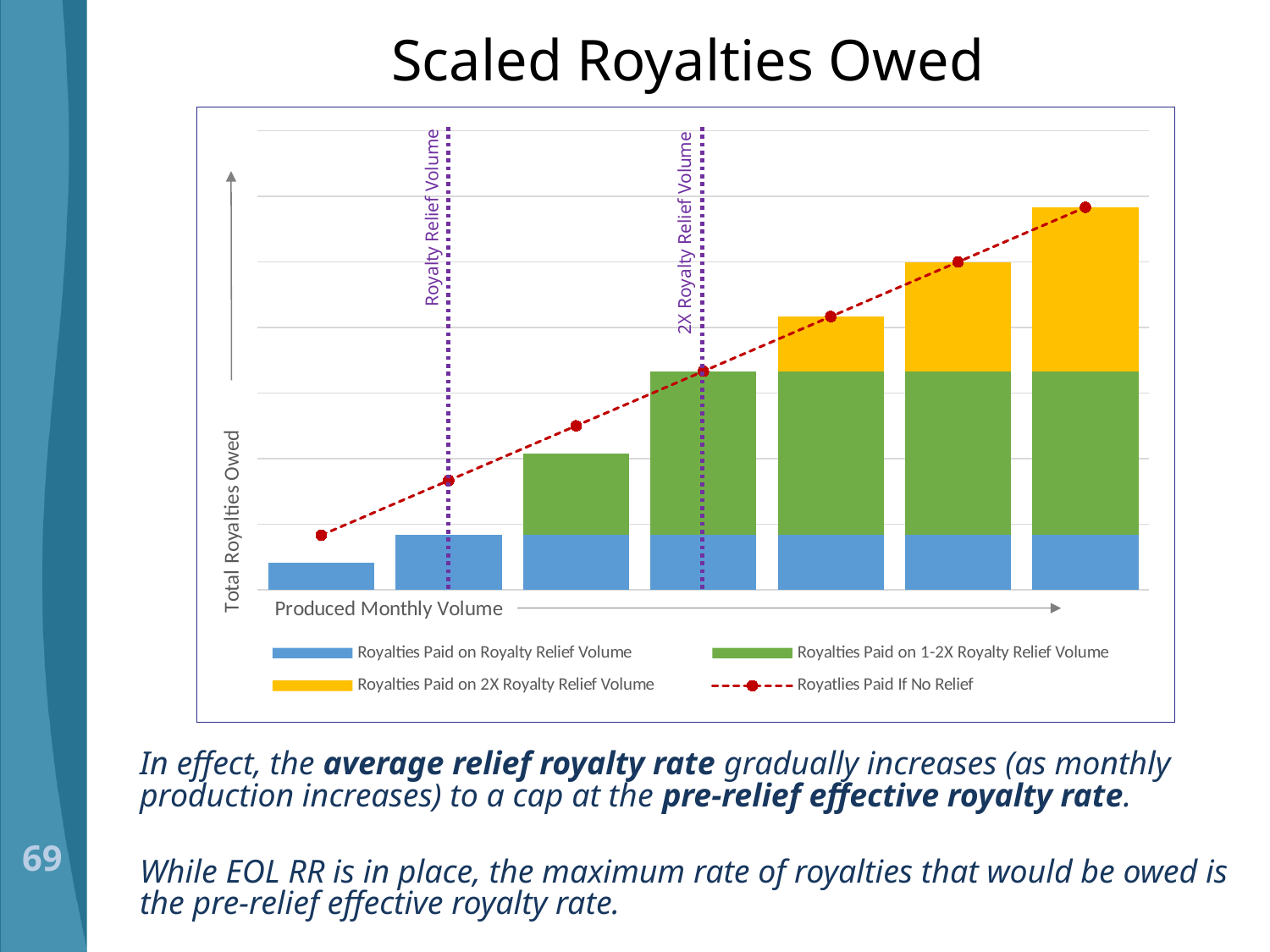
How many bars include a yellow 'Royalties Paid on 2X Royalty Relief Volume' segment? 3 Is the total of the rightmost bar larger or smaller than the total of the leftmost bar? Larger Which bar has the highest total royalties owed? The rightmost (seventh) bar How many bars include a green 'Royalties Paid on 1-2X Royalty Relief Volume' segment? 5 How many series does the legend list? 4 Which series is shown in yellow in the legend? Royalties Paid on 2X Royalty Relief Volume Does the 'Royalties Paid If No Relief' dashed line rise or fall as Produced Monthly Volume increases? Rises How many bars are plotted in the chart? 7 Do the total bar heights rise or fall from left to right along the x axis? Rise Which bar has the lowest total royalties owed? The leftmost (first) bar What kind of chart is shown on the slide? Stacked bar chart with a dashed line What is the label on the vertical axis of the chart? Total Royalties Owed